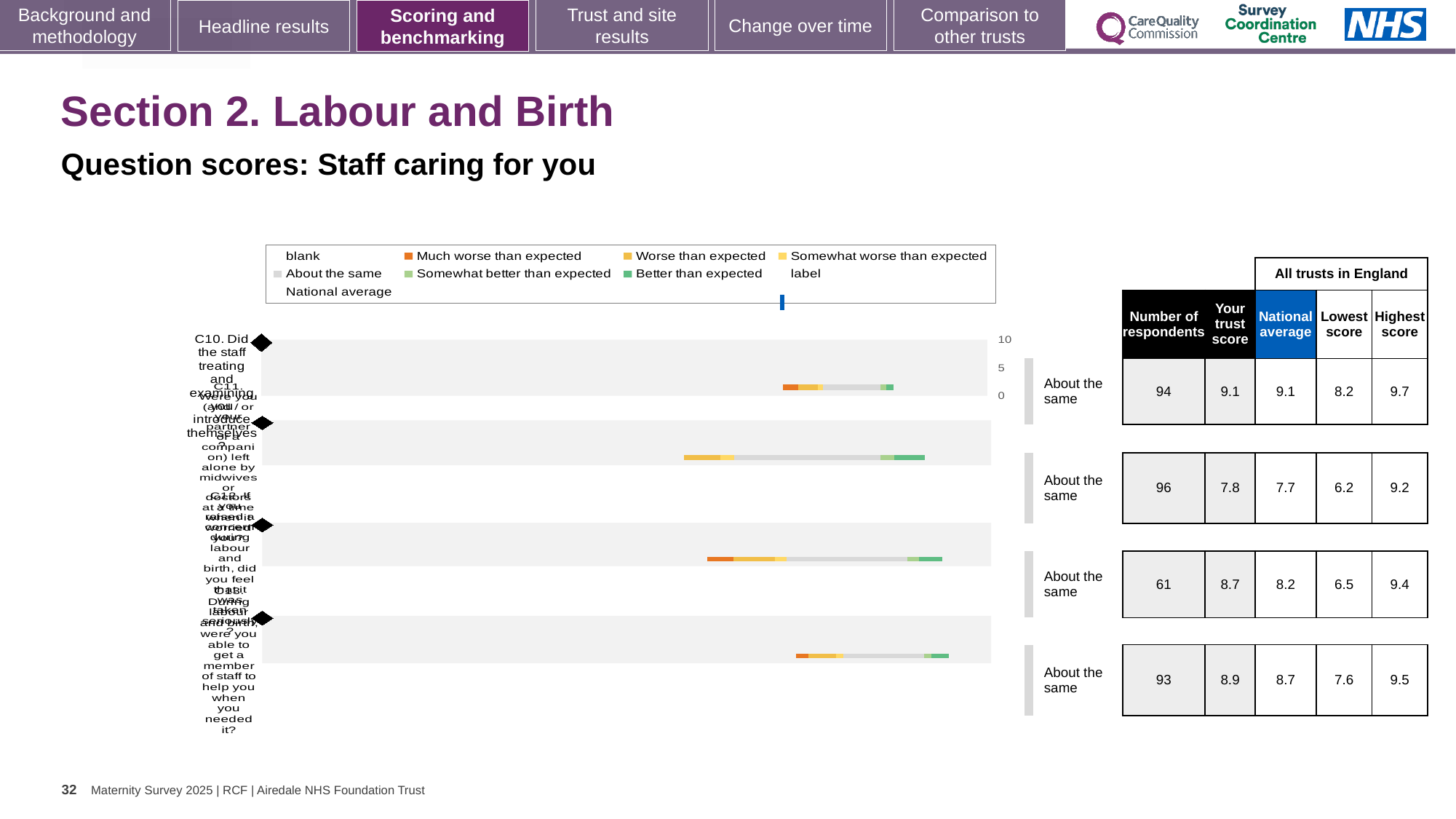
What is the national average for question C12? 8.2 What is the difference between the trust score and the national average for question C12? 0.5 What kind of chart is shown on the slide? bar chart What benchmark category is shown for all four questions? About the same What is the number of respondents for question C10? 94 How many questions (rows) are plotted in the chart? 4 What is the trust score for question C11? 7.8 Which question has the highest number of respondents? C11 For question C13, which is larger: the trust score or the national average? the trust score Which question has the lowest 'Lowest score' value? C11 What is the difference between the highest score and the lowest score for question C10? 1.5 What is the highest score among all trusts in England for question C13? 9.5